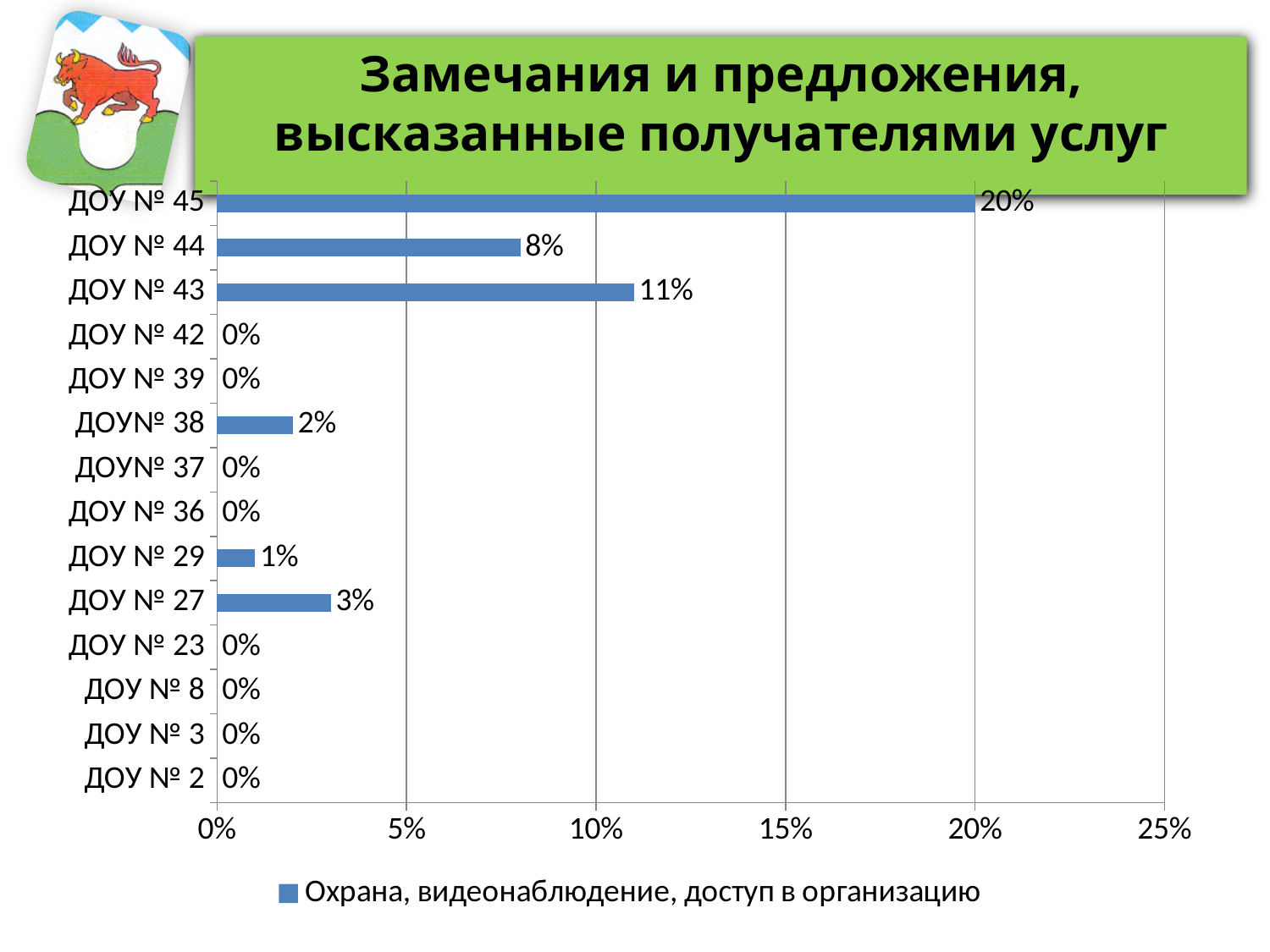
What kind of chart is shown on the slide? bar chart What is the value for ДОУ № 43? 11% Is the value for ДОУ № 45 greater or less than 15%? greater What is the difference between the values for ДОУ № 43 and ДОУ № 38? 9% Which is larger, the value for ДОУ № 44 or the value for ДОУ № 43? ДОУ № 43 Which category has the highest value? ДОУ № 45 How many categories are shown on the chart? 14 What is the value for ДОУ № 29? 1% What is the value for ДОУ № 27? 3% What is the value for ДОУ № 45? 20% What is the difference between the values for ДОУ № 45 and ДОУ № 44? 12% What series does the legend list? Охрана, видеонаблюдение, доступ в организацию